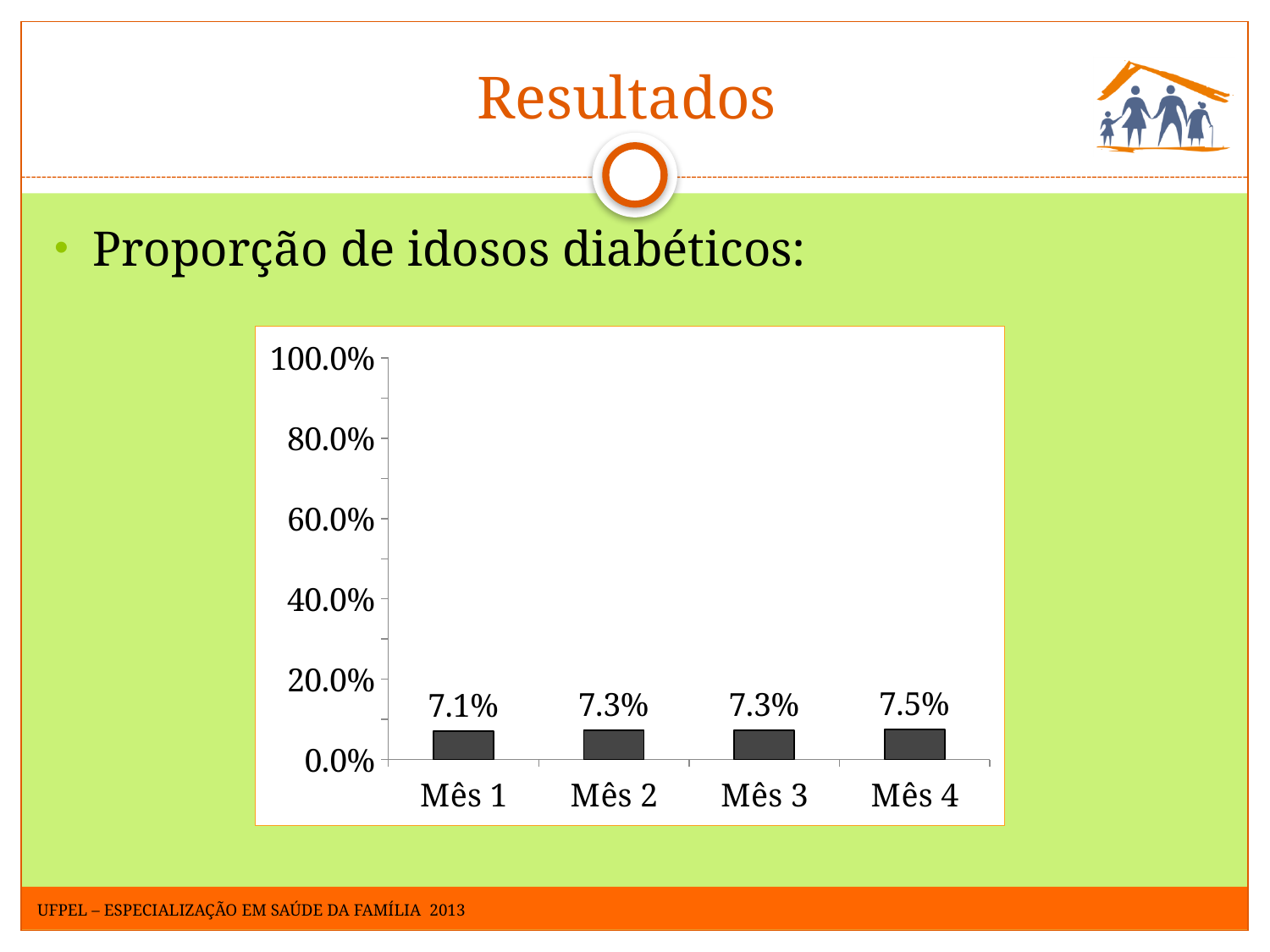
What is the maximum value shown on the y axis? 100.0% What is the value for Mês 2? 7.3% Is the value for Mês 3 greater or less than 20.0%? less What is the difference between the values for Mês 4 and Mês 1? 0.4% Which is larger, the value for Mês 1 or the value for Mês 4? Mês 4 Do the values rise or fall from Mês 1 to Mês 4? rise Which month has the lowest value? Mês 1 What kind of chart is shown on the slide? bar chart What is the value for Mês 1? 7.1% How many months are shown on the x axis? 4 Which month has the highest value? Mês 4 What is the value for Mês 4? 7.5%